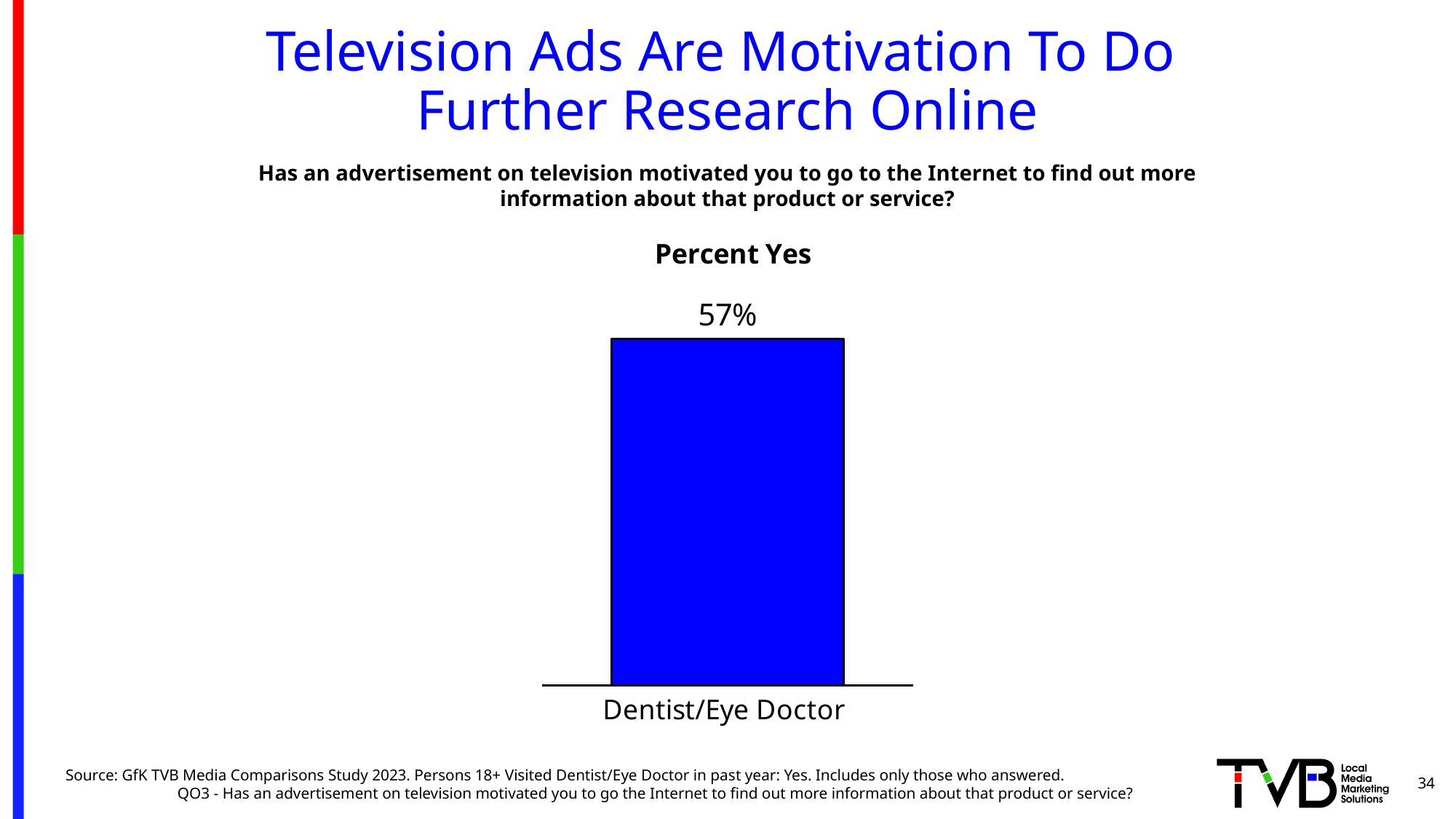
What is the label of the single category on the x axis? Dentist/Eye Doctor Is the value for Dentist/Eye Doctor greater or less than 50%? greater What kind of chart is shown on the slide? bar chart How many categories are plotted in the chart? 1 What is the title of the chart? Percent Yes What is the Percent Yes value for Dentist/Eye Doctor? 57%